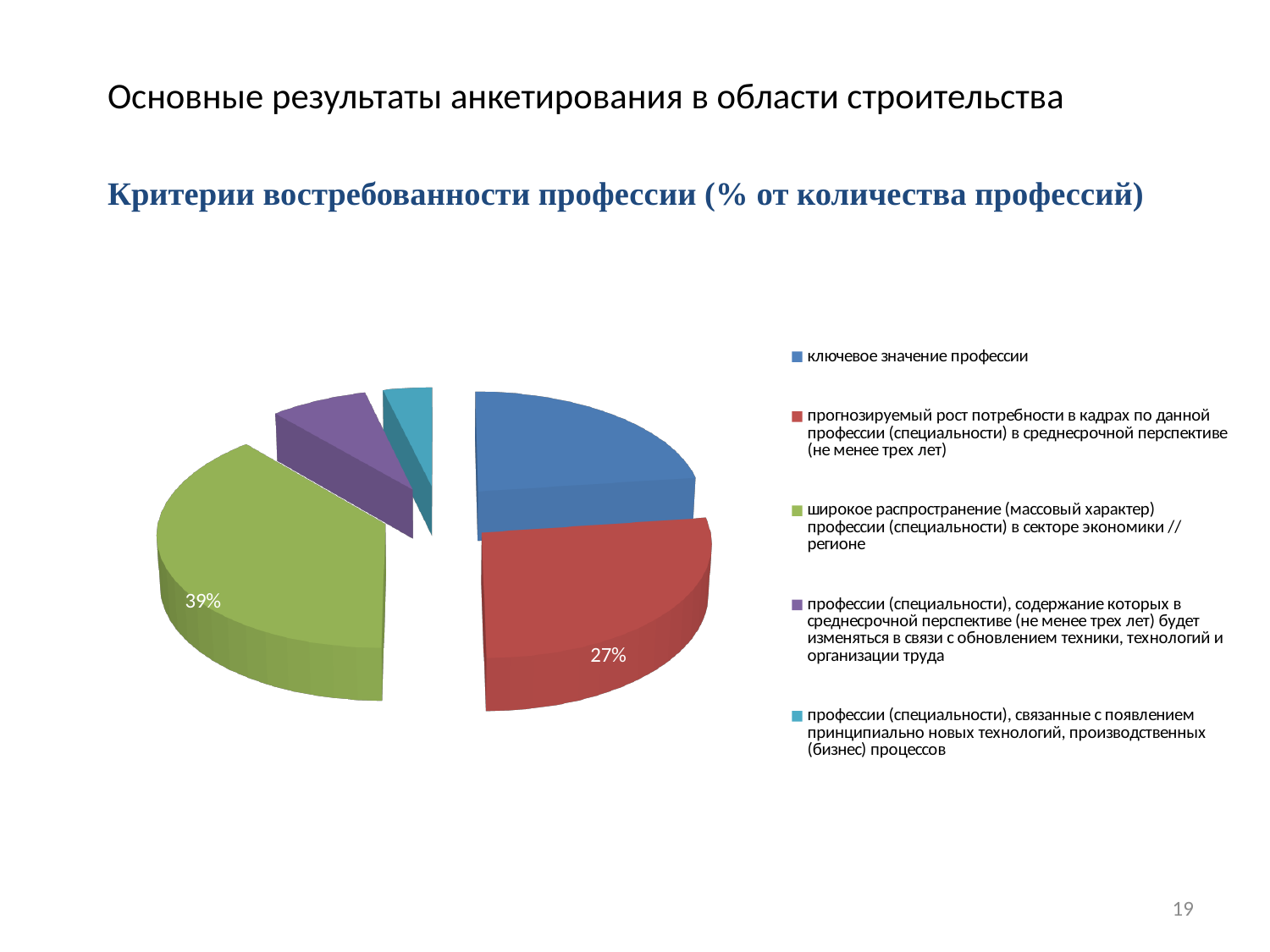
What kind of chart is shown on the slide? pie chart Which category has the largest slice of the pie? широкое распространение (массовый характер) профессии (специальности) в секторе экономики // регионе Which slice is larger: 'ключевое значение профессии' or 'профессии (специальности), связанные с появлением принципиально новых технологий'? ключевое значение профессии What colour is the slice for 'ключевое значение профессии'? blue What is the difference in percentage points between the green slice (39%) and the red slice (27%)? 12 How many slices does the pie chart have? 5 What is the title of the chart on the slide? Критерии востребованности профессии (% от количества профессий) Which slice is larger: 'широкое распространение (массовый характер) профессии' or 'прогнозируемый рост потребности в кадрах'? широкое распространение (массовый характер) профессии (специальности) в секторе экономики // регионе How many entries does the chart legend list? 5 What share of the pie is labelled for 'прогнозируемый рост потребности в кадрах по данной профессии (специальности) в среднесрочной перспективе (не менее трех лет)'? 27% Which category has the smallest slice of the pie? профессии (специальности), связанные с появлением принципиально новых технологий, производственных (бизнес) процессов What share of the pie is labelled for 'широкое распространение (массовый характер) профессии (специальности) в секторе экономики // регионе'? 39%